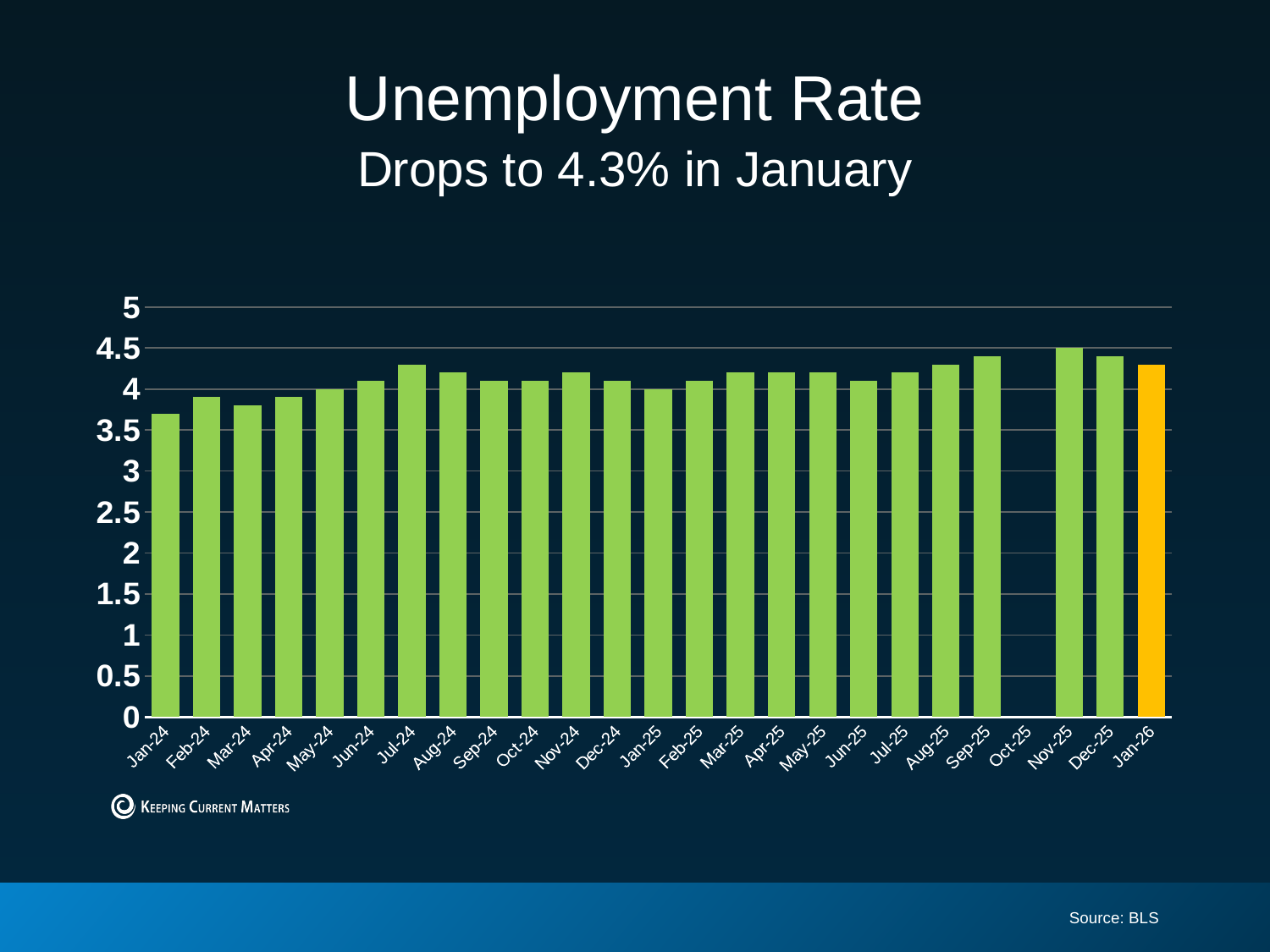
Which month has the lowest unemployment rate in the chart? Jan-24 What is the unemployment rate for Jan-26 according to the slide? 4.3% Is the unemployment rate for Jul-24 greater or less than 4? greater How many month labels are shown on the x axis? 25 Does the unemployment rate generally rise or fall from Jan-24 to Jan-26? Rise Which month has the highest unemployment rate in the chart? Nov-25 What type of chart is shown on the slide? Bar chart Which is larger, the unemployment rate for Nov-25 or for Jan-24? Nov-25 Which month on the x axis has no bar plotted? Oct-25 Is the unemployment rate for Jan-24 greater or less than 4? less What colour is the bar for Jan-26? Orange Is the unemployment rate for Sep-25 greater or less than 4? greater